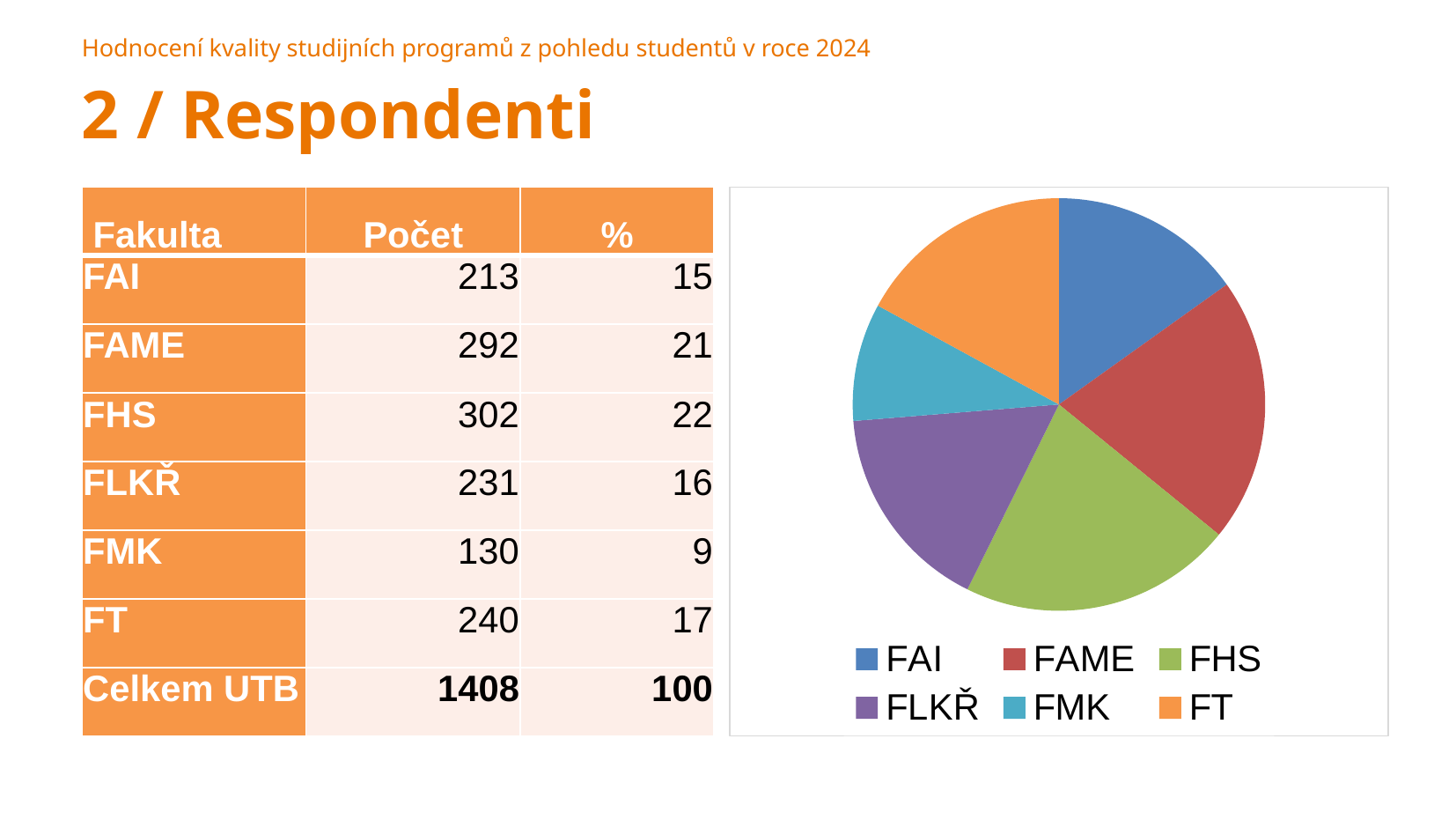
What kind of chart is shown on the slide? pie chart Which faculty has the smallest slice in the pie chart? FMK How many categories (faculties) does the pie chart show? 6 What is the difference in respondent count between FHS and FAI? 89 What share of respondents does the FHS slice represent, according to the table? 22 Which colour represents FLKŘ in the pie chart legend? purple How many respondents does the FT slice represent (Počet)? 240 What is the total number of respondents across all slices (Celkem UTB)? 1408 What share of respondents does the FMK slice represent, according to the table? 9 Which slice is larger, FT or FMK? FT Which faculty has the largest slice in the pie chart? FHS How many respondents does the FAI slice represent (Počet)? 213